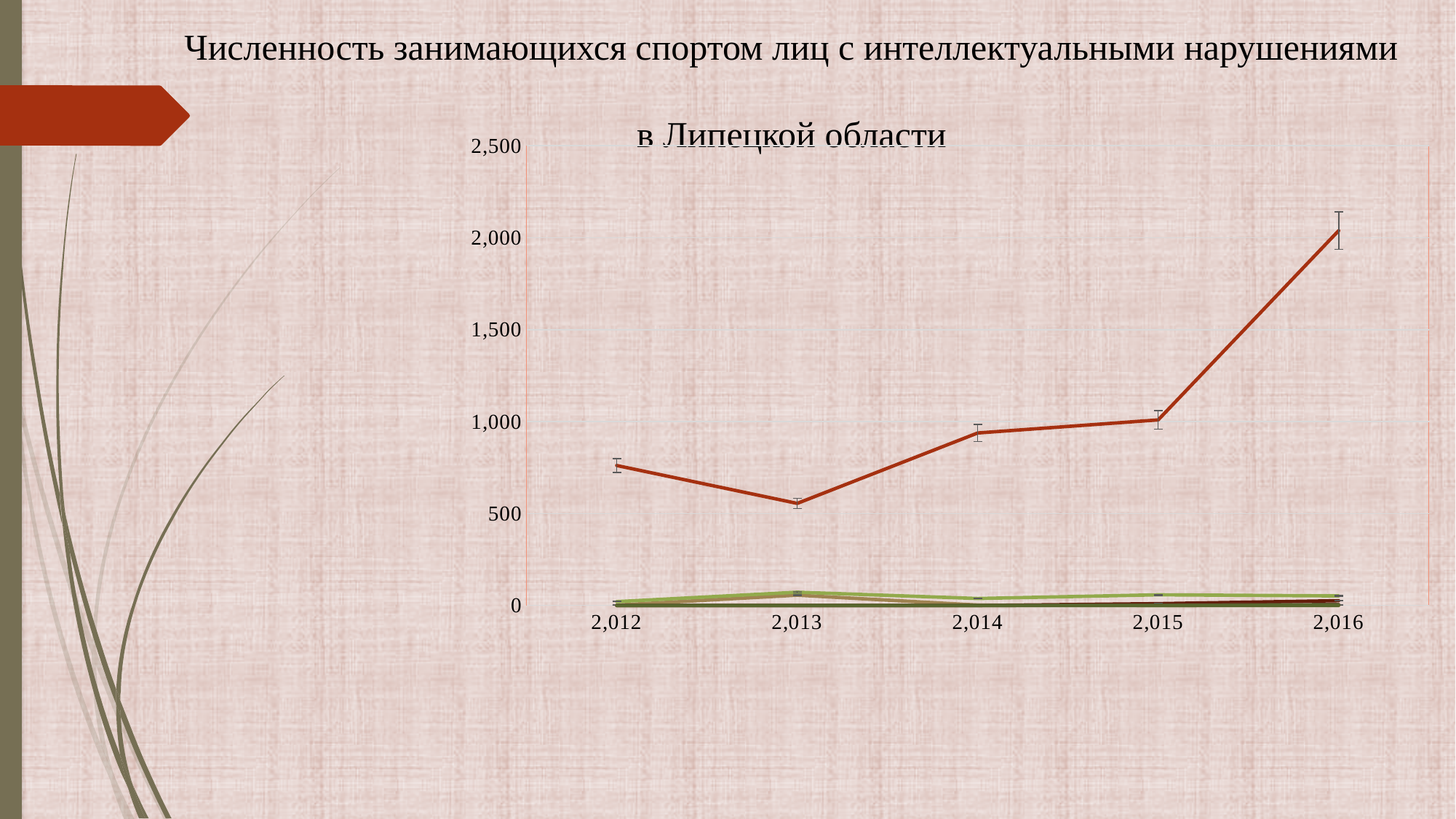
In which year does the red (top) line reach its lowest value? 2,013 Which year has the larger value on the red line, 2,012 or 2,016? 2,016 Is the value of the red line for 2,016 greater or less than 1,500? greater Does the red line rise or fall from 2,012 to 2,013? fall In which year does the red (top) line reach its highest value? 2,016 Which year has the larger value on the red line, 2,013 or 2,014? 2,014 What is the highest value shown on the y axis of the chart? 2,500 What kind of chart is shown on the slide? line chart How many years are shown along the x axis of the chart? 5 Is the value of the red line for 2,013 greater or less than 1,000? less Is the value of the red line for 2,012 greater or less than 500? greater Does the red line rise or fall from 2,013 to 2,016? rise